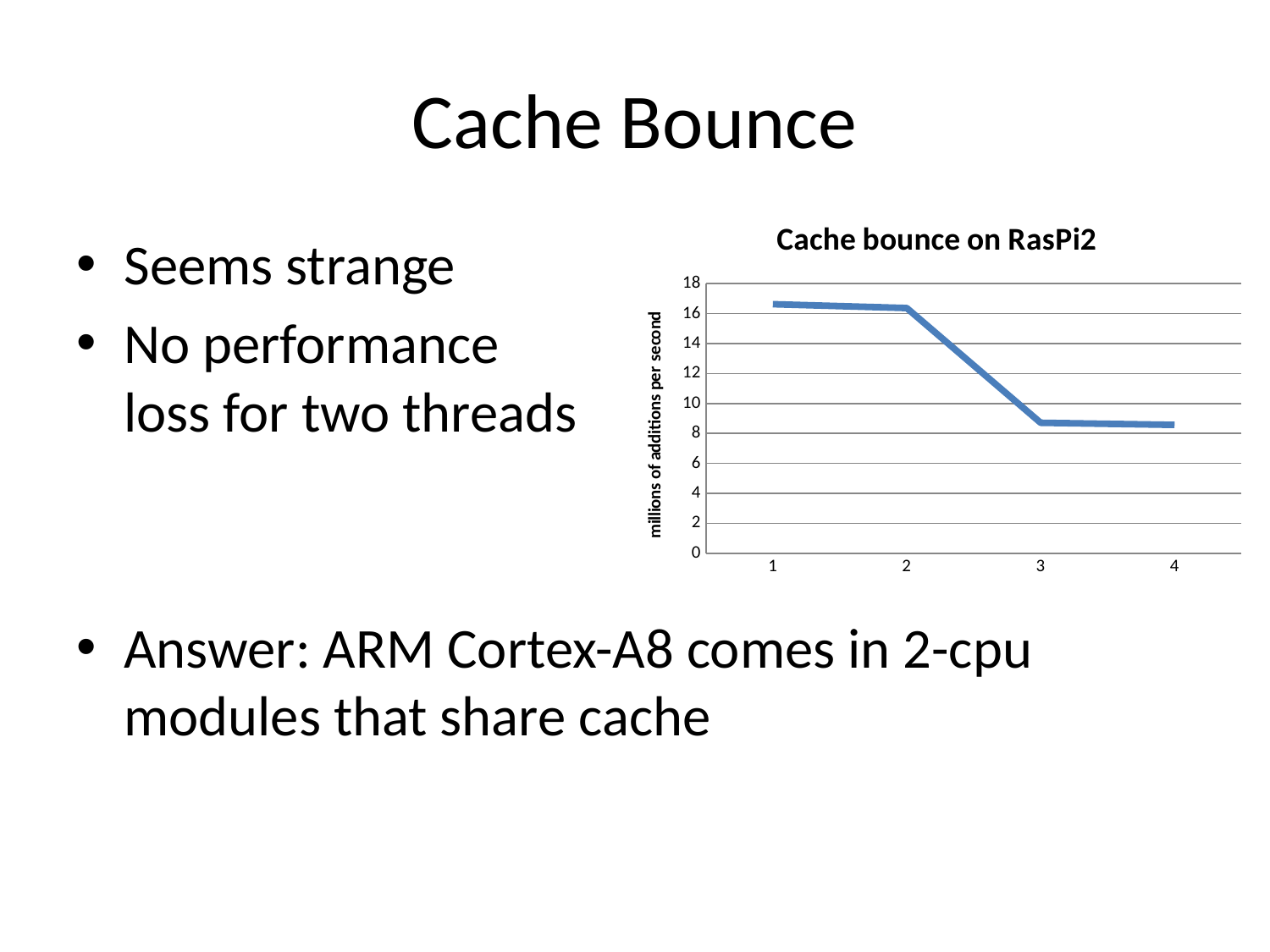
Is the value at x = 3 greater or less than 6? greater Is the value at x = 1 greater or less than 14? greater Is the value at x = 2 greater or less than 14? greater What is the title of the chart? Cache bounce on RasPi2 Do the values rise or fall as you move from 1 to 4 along the x axis? fall Which has the larger value, x = 1 or x = 3? 1 What is the label on the vertical axis of the chart? millions of additions per second Which has the larger value, x = 2 or x = 4? 2 What kind of chart is shown on the slide? line chart How many data points are plotted on the line? 4